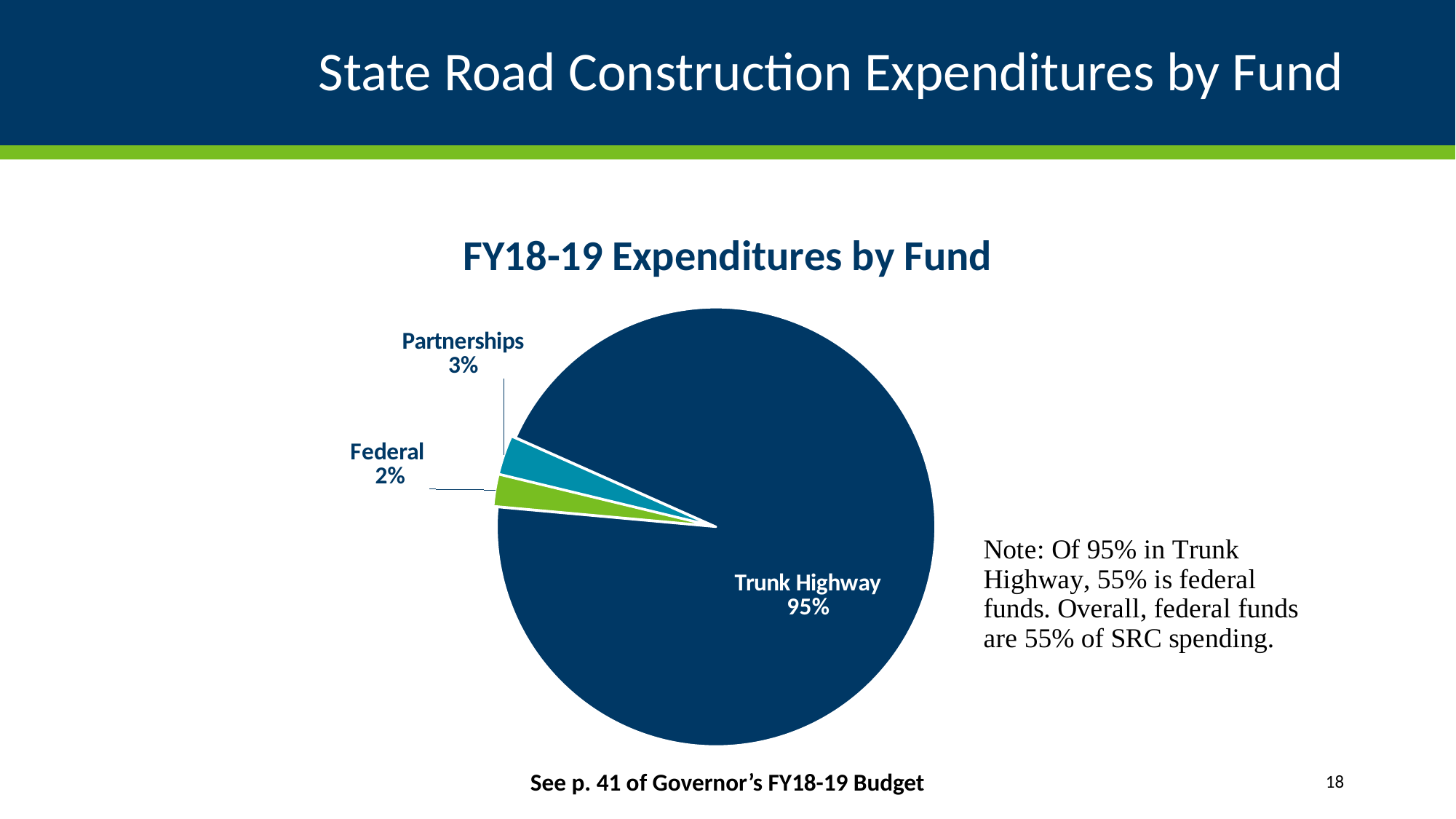
Which fund has the smallest share of FY18-19 expenditures? Federal What share of FY18-19 expenditures is Trunk Highway? 95% What share of FY18-19 expenditures is Federal? 2% Which fund has the largest share of FY18-19 expenditures? Trunk Highway What is the difference in percentage points between the Partnerships share and the Federal share? 1 Which is larger, the Partnerships share or the Federal share? Partnerships What share of FY18-19 expenditures is Partnerships? 3% How many funds are shown in the pie chart? 3 What is the difference in percentage points between the Trunk Highway share and the Partnerships share? 92 What is the title of the chart? FY18-19 Expenditures by Fund What colour is the Federal slice of the pie? Green What kind of chart is shown on the slide? Pie chart